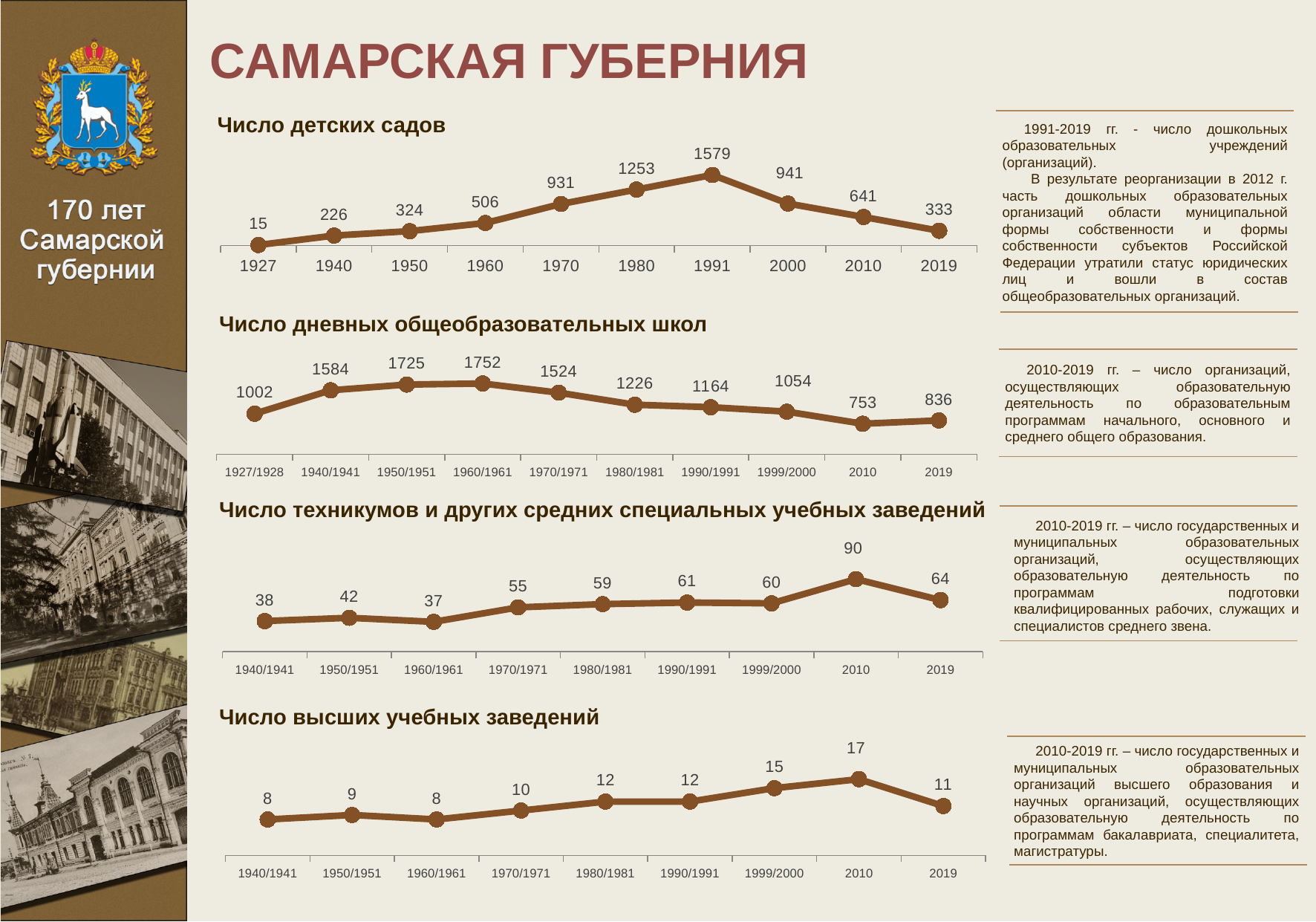
In the chart 'Число техникумов и других средних специальных учебных заведений', what is the value for 2010? 90 In the chart 'Число детских садов', which year has the lowest value? 1927 In the chart 'Число дневных общеобразовательных школ', what is the value for 2010? 753 In the chart 'Число техникумов и других средних специальных учебных заведений', what is the difference between the values for 2010 and 2019? 26 In the chart 'Число техникумов и других средних специальных учебных заведений', which is larger, the value for 1990/1991 or the value for 1999/2000? 1990/1991 What type of chart is 'Число высших учебных заведений'? Line chart In the chart 'Число детских садов', what is the value for 1991? 1579 In the chart 'Число высших учебных заведений', what is the value for 1999/2000? 15 In the chart 'Число дневных общеобразовательных школ', which period has the highest value? 1960/1961 In the chart 'Число дневных общеобразовательных школ', how many data points are plotted? 10 In the chart 'Число детских садов', what is the difference between the values for 2000 and 2019? 608 In the chart 'Число высших учебных заведений', how many data points are plotted? 9